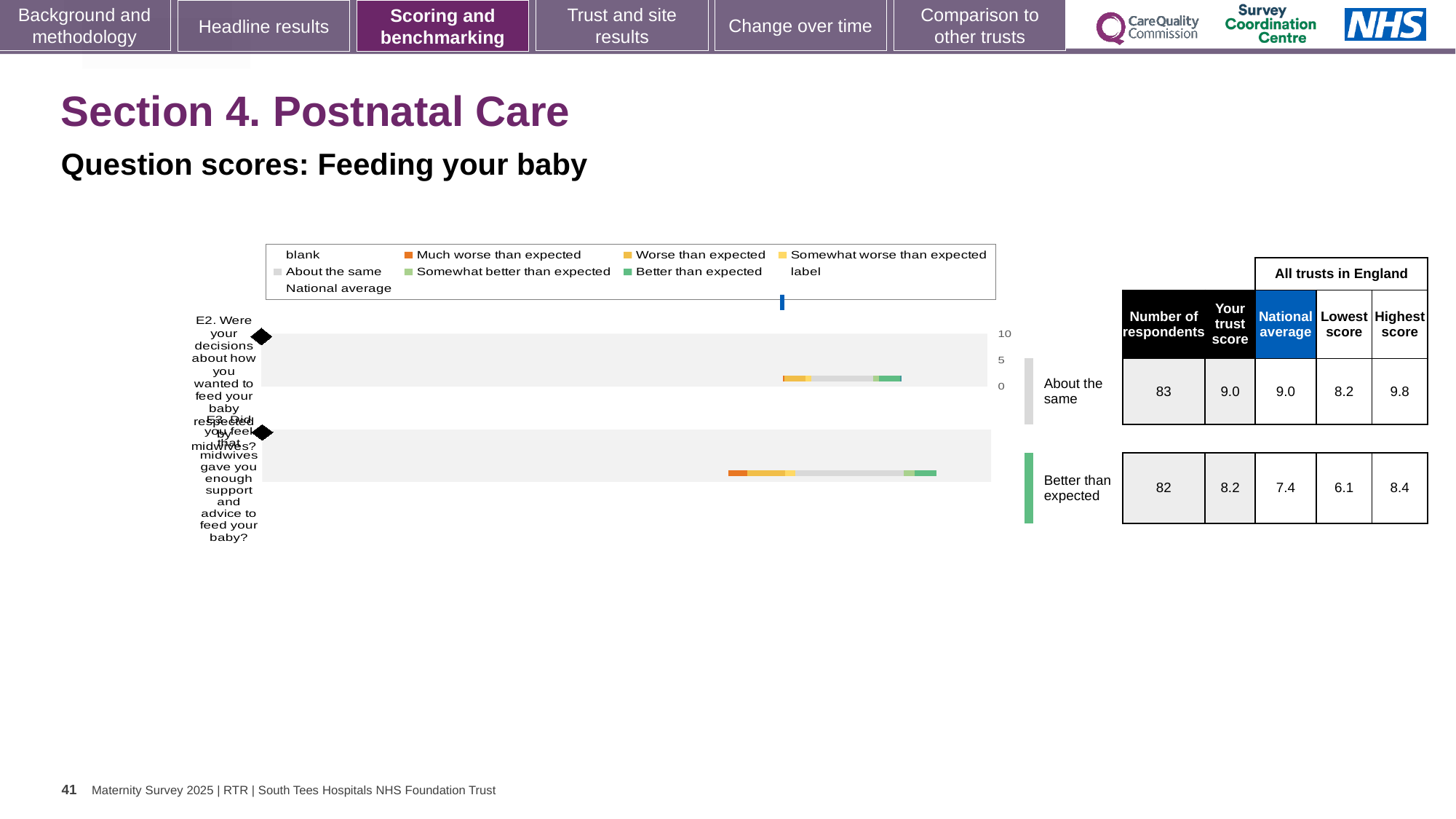
What is the national average for E3 (midwives gave you enough support and advice to feed your baby)? 7.4 Which benchmark category is shown for E2? About the same By how much does the trust score for E2 exceed the trust score for E3? 0.8 Which question has the higher trust score, E2 or E3? E2 Which benchmark category is shown for E3? Better than expected What is the lowest score among all trusts in England for E2? 8.2 What is the difference between the highest and lowest scores for E3? 2.3 What kind of chart is shown on the slide? bar chart How many questions (categories) are plotted in the chart? 2 What is the highest score among all trusts in England for E2? 9.8 How many respondents answered question E3? 82 What is the trust score for E2 (decisions about how you wanted to feed your baby respected by midwives)? 9.0